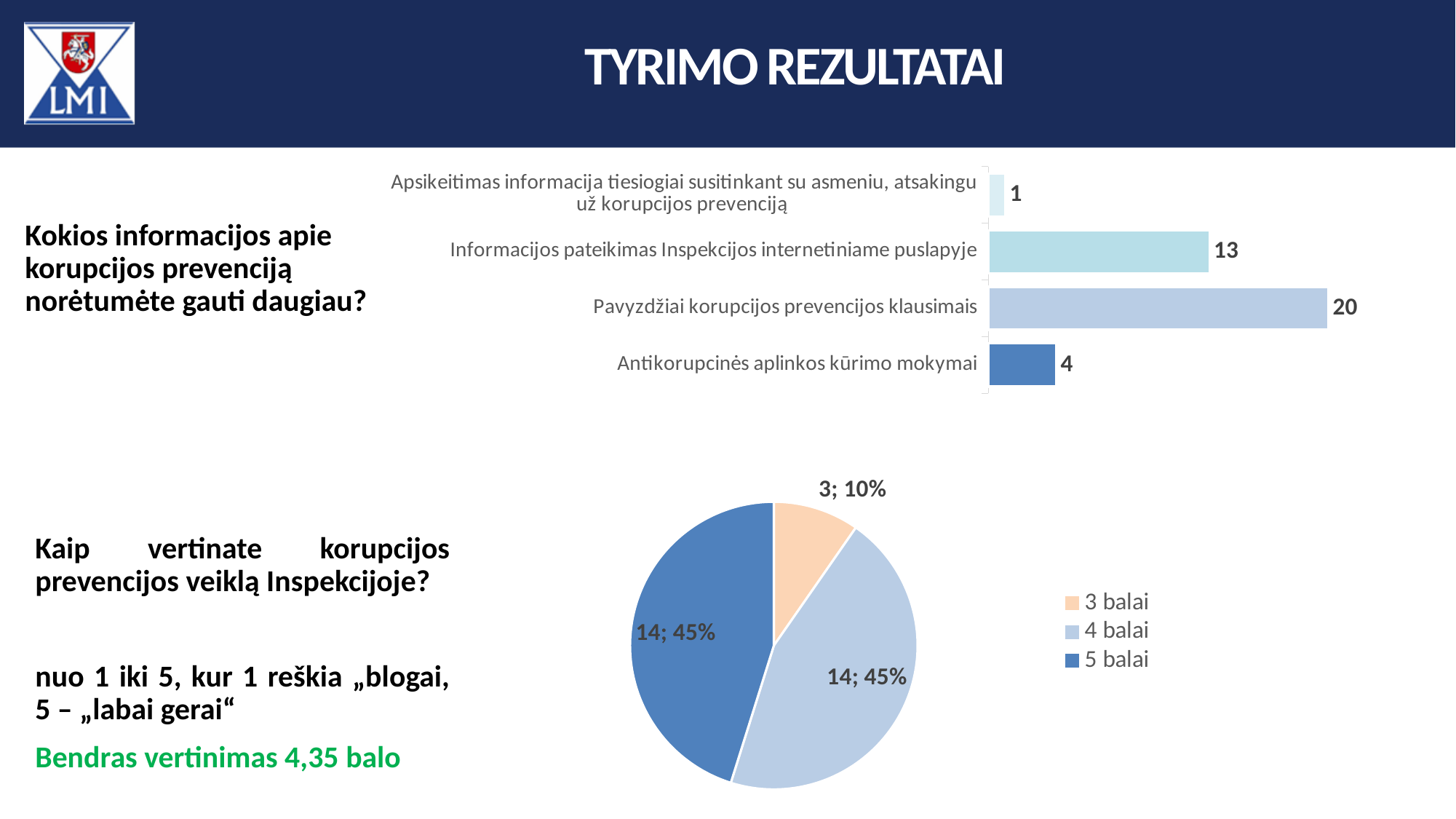
In the bottom pie chart, what is the value for "5 balai"? 14 In the top bar chart, which category has the highest value? Pavyzdžiai korupcijos prevencijos klausimais In the top bar chart, which category has the lowest value? Apsikeitimas informacija tiesiogiai susitinkant su asmeniu, atsakingu už korupcijos prevenciją In the top bar chart, how many categories are shown? 4 In the top bar chart, what is the value for "Pavyzdžiai korupcijos prevencijos klausimais"? 20 In the top bar chart, what is the value for "Antikorupcinės aplinkos kūrimo mokymai"? 4 How many series does the legend of the bottom pie chart list? 3 In the top bar chart, what is the difference between the values for "Pavyzdžiai korupcijos prevencijos klausimais" and "Informacijos pateikimas Inspekcijos internetiniame puslapyje"? 7 What kind of chart is the top chart on the slide? Bar chart In the top bar chart, what is the value for "Informacijos pateikimas Inspekcijos internetiniame puslapyje"? 13 In the bottom pie chart, what share does "3 balai" have? 10% What kind of chart is the bottom chart on the slide? Pie chart